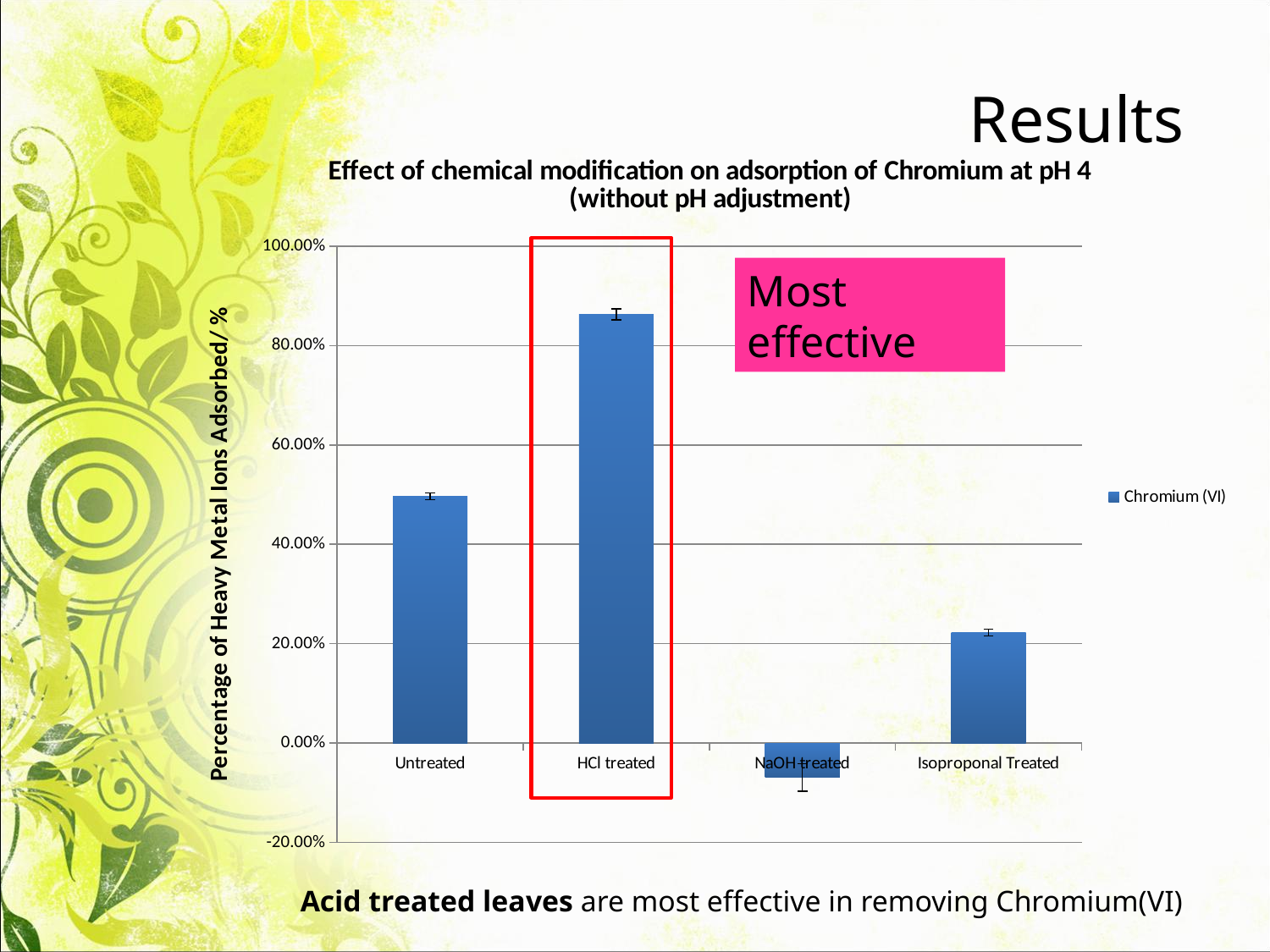
Which is larger, the value for Untreated or the value for Isoproponal Treated? Untreated Is the value for Isoproponal Treated greater or less than 40.00%? less Is the value for NaOH treated greater or less than 0.00%? less Is the value for HCl treated greater or less than 80.00%? greater What kind of chart is shown on the slide? bar chart What series name appears in the chart legend? Chromium (VI) How many series does the chart legend list? 1 How many categories are plotted on the x axis of the chart? 4 Which category has the highest percentage of heavy metal ions adsorbed? HCl treated Which category has the lowest percentage of heavy metal ions adsorbed? NaOH treated What is the title of the chart? Effect of chemical modification on adsorption of Chromium at pH 4 (without pH adjustment)